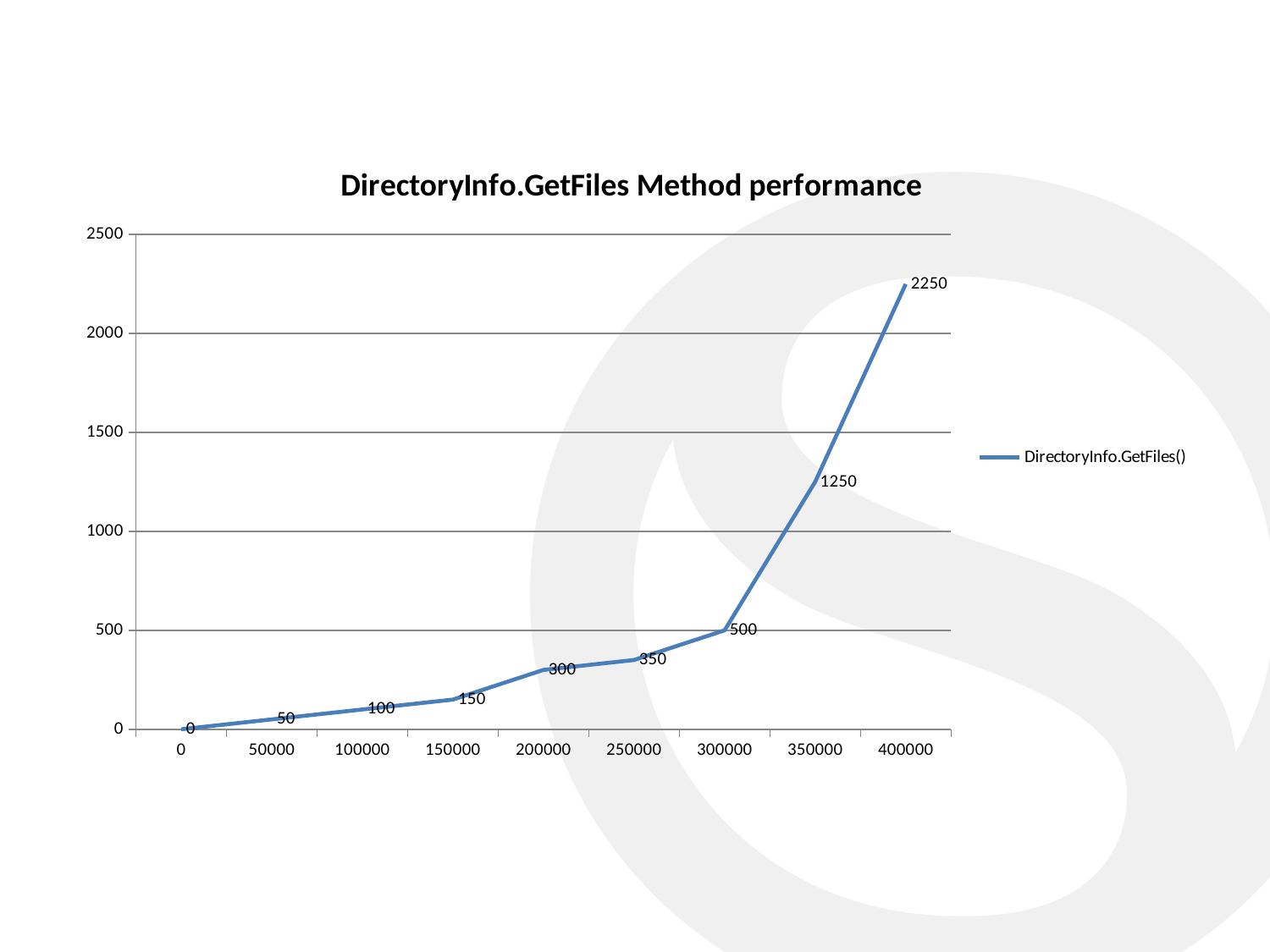
What is the value of DirectoryInfo.GetFiles() at 200000? 300 How many data points are plotted on the line? 9 Which is larger, the value at 250000 or the value at 150000? 250000 At which x value is DirectoryInfo.GetFiles() lowest? 0 What is the value of DirectoryInfo.GetFiles() at 400000? 2250 How many series does the legend list? 1 What is the value of DirectoryInfo.GetFiles() at 300000? 500 Do the values rise or fall as the x axis increases? rise What kind of chart is shown on the slide? line chart At which x value is DirectoryInfo.GetFiles() highest? 400000 What is the title of the chart? DirectoryInfo.GetFiles Method performance What is the difference between the values at 400000 and 350000? 1000